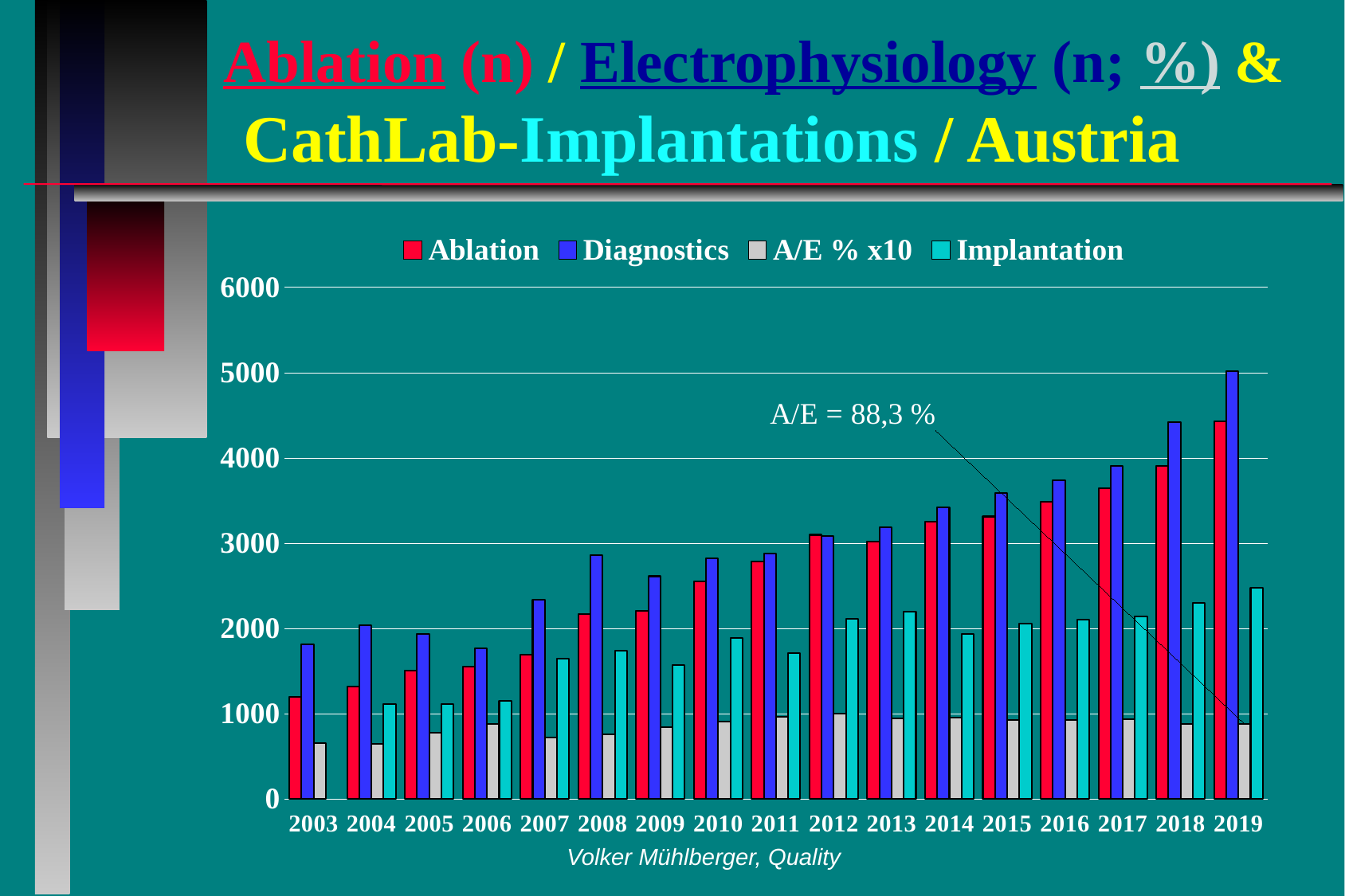
How many years are shown on the x axis? 17 How many series does the legend list? 4 Is the Diagnostics value for 2018 greater or less than 4000? greater What kind of chart is shown on the slide? bar chart Is the Implantation value for 2019 greater or less than 2000? greater In which year is the Diagnostics value highest? 2019 Is the A/E % x10 value for 2003 greater or less than 1000? less In 2008, which is larger: Ablation or Diagnostics? Diagnostics Do the Diagnostics values generally rise or fall from 2003 to 2019? rise What A/E percentage is annotated on the chart? 88,3 % In which year is the Ablation value lowest? 2003